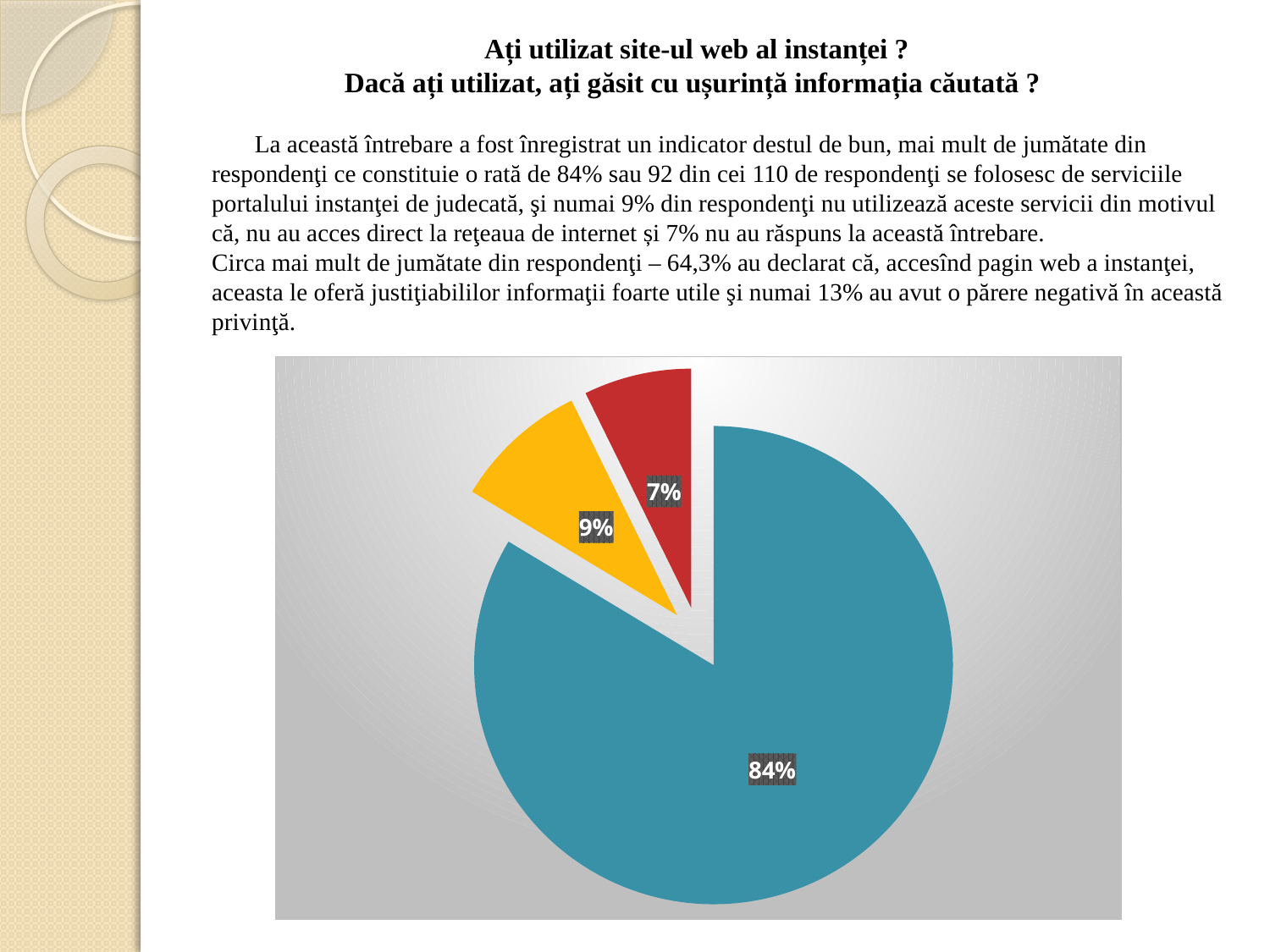
How many slices does the pie chart have? 3 Which slice is larger, the yellow slice or the red slice? the yellow slice What is the value of the largest slice of the pie chart? 84% What is the difference in percentage points between the blue slice and the yellow slice? 75 What percentage is shown on the red slice of the pie chart? 7% What percentage is shown on the yellow slice of the pie chart? 9% What is the value of the smallest slice of the pie chart? 7% What is the difference in percentage points between the yellow slice and the red slice? 2 What colour is the largest slice of the pie chart? blue Does the pie chart have a legend? no What kind of chart is shown on the slide? pie chart What percentage is shown on the blue slice of the pie chart? 84%